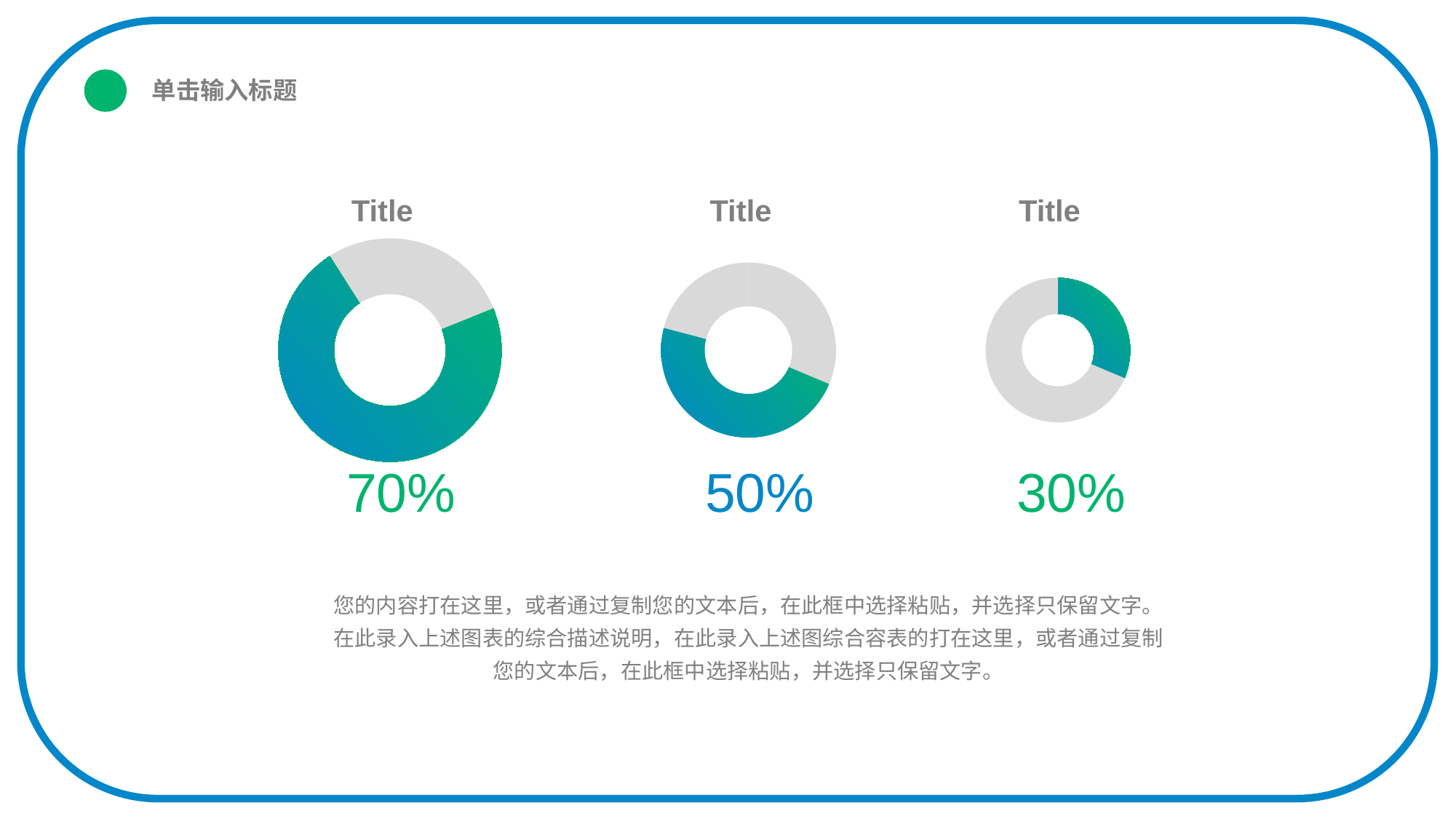
What percentage is shown below the left donut chart? 70% What title is shown above each of the three donut charts? Title What is the difference between the percentage of the left donut chart and the percentage of the right donut chart? 40% What percentage is shown below the middle donut chart? 50% Which is larger, the percentage of the middle donut chart or the percentage of the right donut chart? middle Which of the three donut charts shows the highest percentage: left, middle or right? left What percentage is shown below the right donut chart? 30% How many donut charts are on the slide? 3 What kind of chart is used for the three charts on the slide? donut chart Which of the three donut charts shows the lowest percentage: left, middle or right? right What is the difference between the percentage of the middle donut chart and the percentage of the right donut chart? 20%